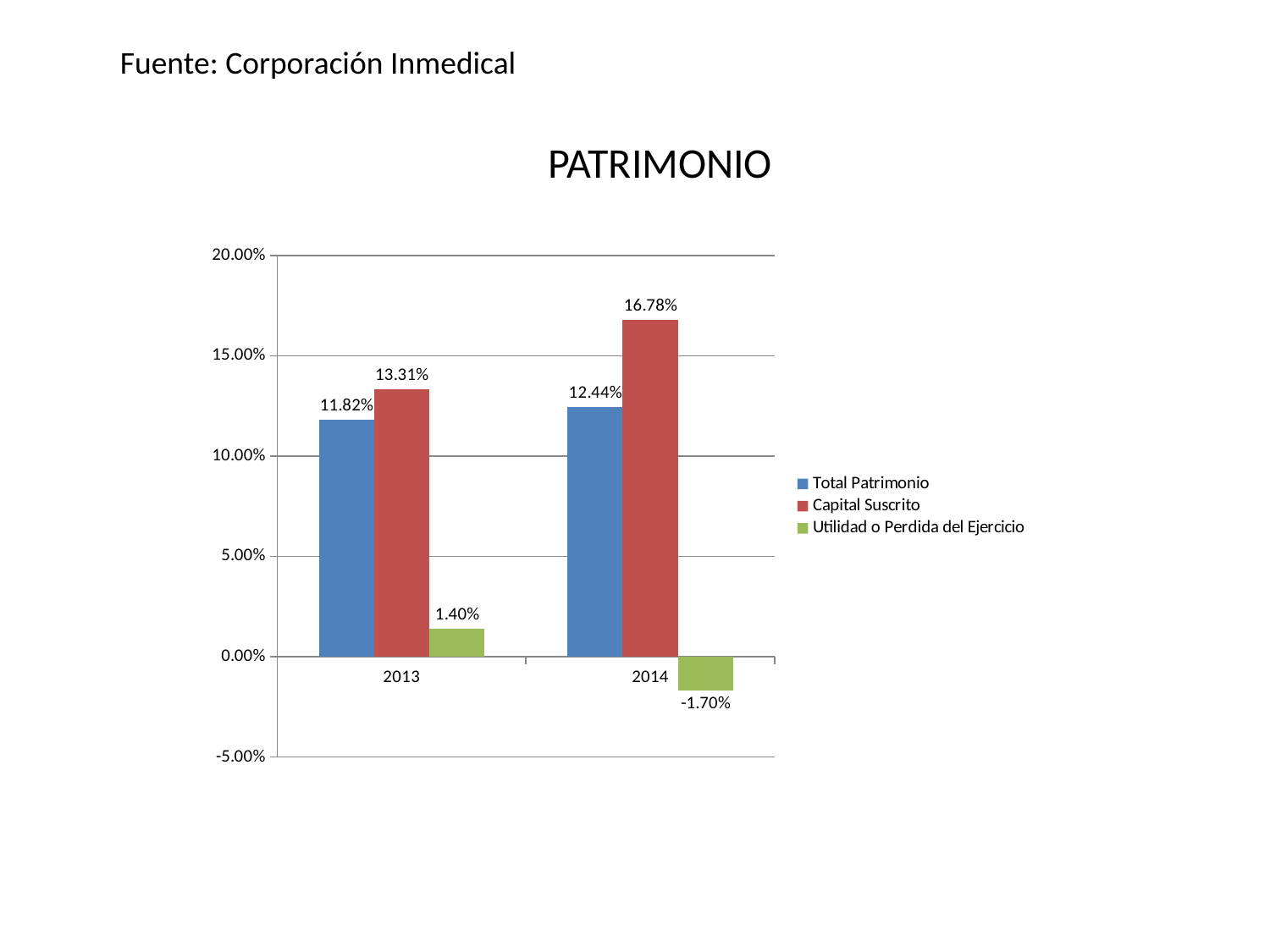
Is the value of Capital Suscrito for 2014 greater or less than 15.00%? greater What is the value of Total Patrimonio for 2013? 11.82% How many years are shown on the x axis? 2 Is Total Patrimonio larger in 2013 or in 2014? 2014 What kind of chart is shown on the slide? Bar chart Which year has the higher value for Capital Suscrito? 2014 What is the value of Utilidad o Perdida del Ejercicio for 2013? 1.40% How many series does the legend list? 3 What is the value of Capital Suscrito for 2014? 16.78% What is the value of Utilidad o Perdida del Ejercicio for 2014? -1.70% What is the difference between Capital Suscrito in 2014 and in 2013? 3.47% Which series has the lowest value in 2014? Utilidad o Perdida del Ejercicio